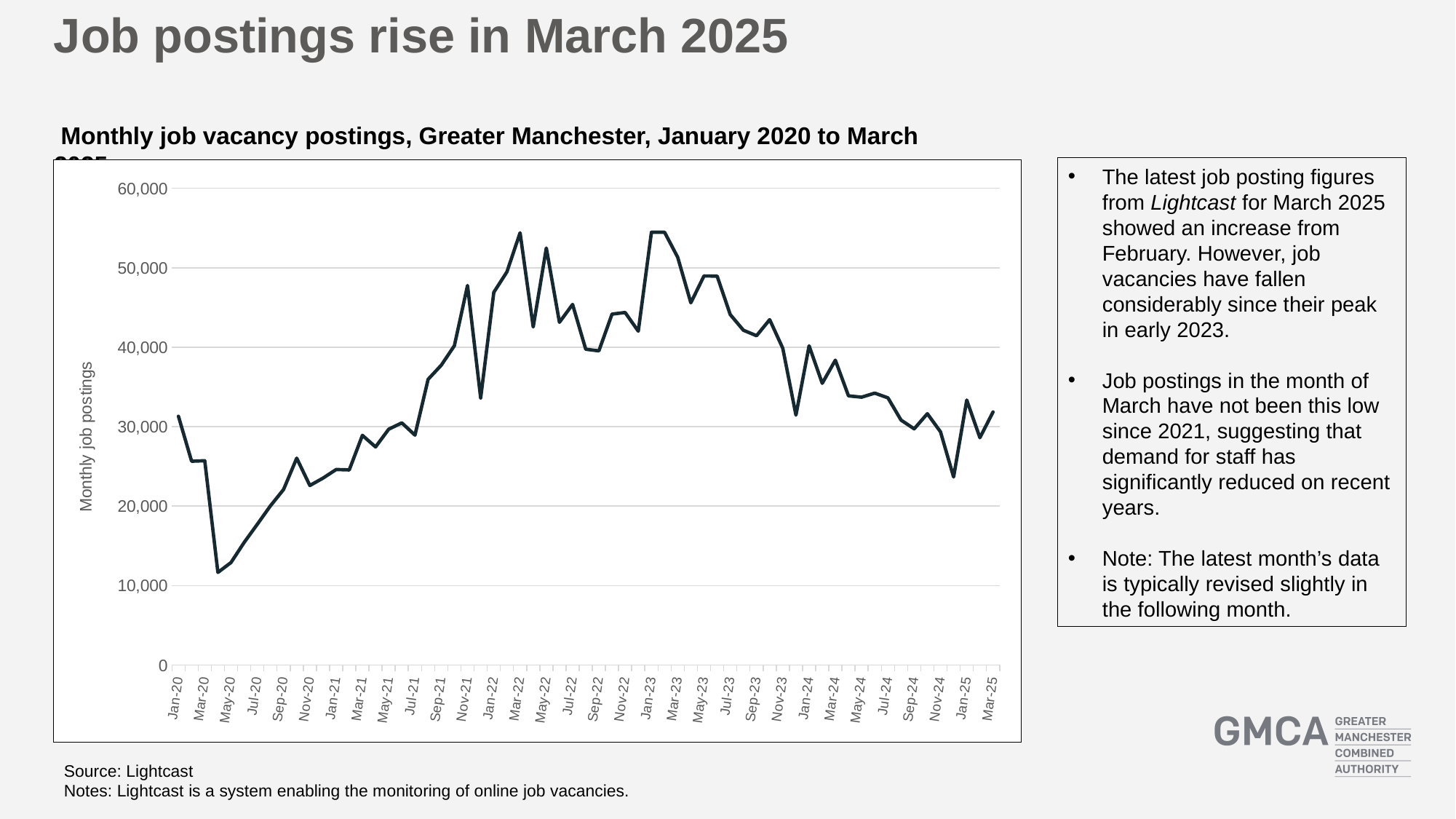
Is the value for Jan-23 greater or less than 50,000? greater Is the value for Mar-22 greater or less than 50,000? greater Do the values rise or fall between May-20 and Nov-21? rise Which is larger, the value for Mar-22 or the value for Mar-25? Mar-22 Which month has the lowest number of monthly job postings? Apr-20 What is the title of the chart? Monthly job vacancy postings, Greater Manchester, January 2020 to March 2025 Do the values rise or fall between Jan-20 and May-20? fall Is the value for Jan-20 greater or less than 30,000? greater What kind of chart is shown on the slide? line chart What is the label on the vertical axis of the chart? Monthly job postings